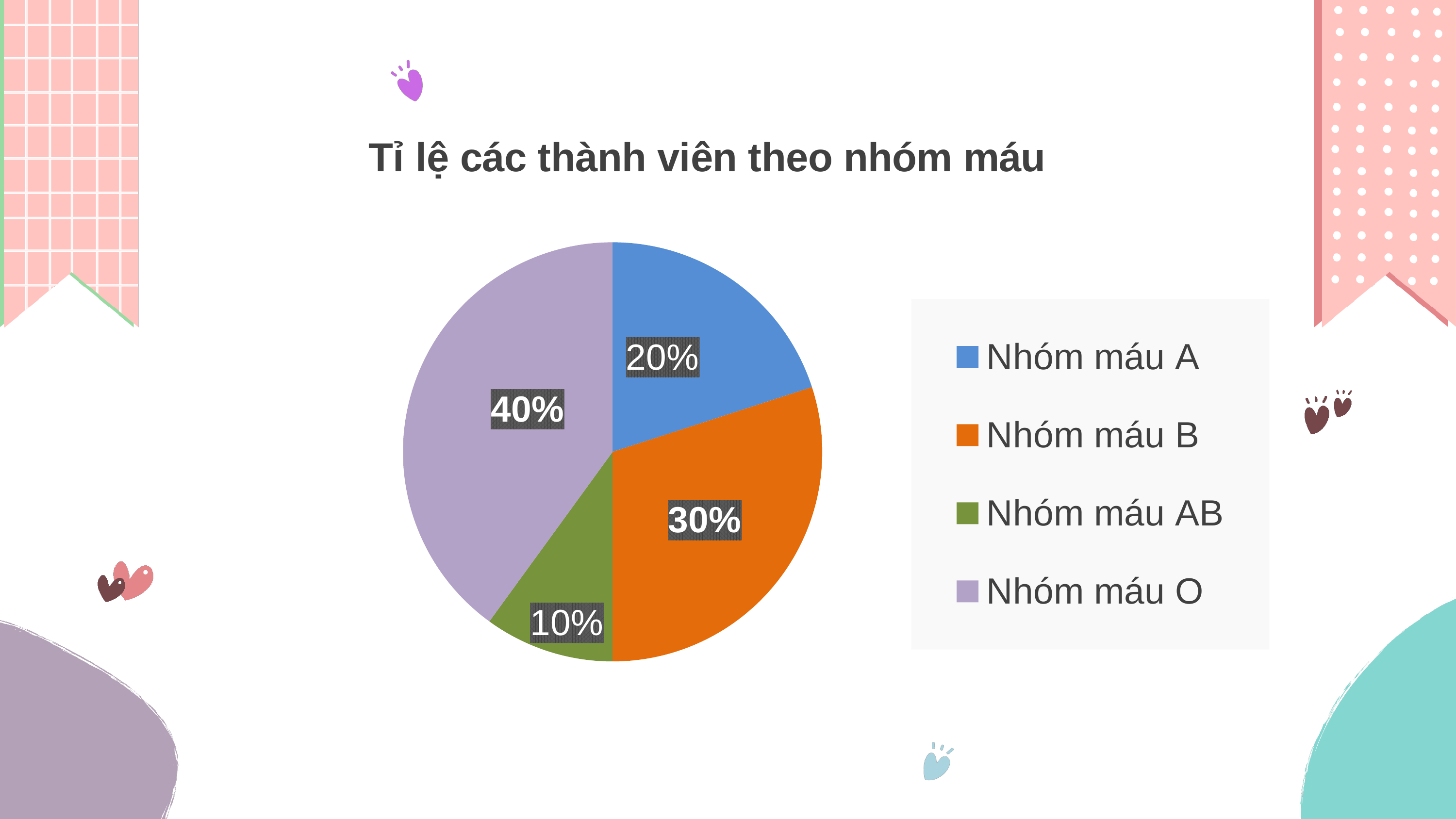
What percentage of members have blood group A (Nhóm máu A)? 20% What is the difference in percentage points between Nhóm máu O and Nhóm máu A? 20% Which has a larger share, Nhóm máu B or Nhóm máu A? Nhóm máu B Which blood group has the smallest share of members? Nhóm máu AB Which blood group has the largest share of members? Nhóm máu O How many blood groups are shown in the pie chart? 4 What is the title of the chart? Tỉ lệ các thành viên theo nhóm máu What type of chart is shown on the slide? Pie chart What percentage of members have blood group AB (Nhóm máu AB)? 10% What percentage of members have blood group B (Nhóm máu B)? 30% What percentage of members have blood group O (Nhóm máu O)? 40% Which colour represents Nhóm máu AB in the pie chart? Green